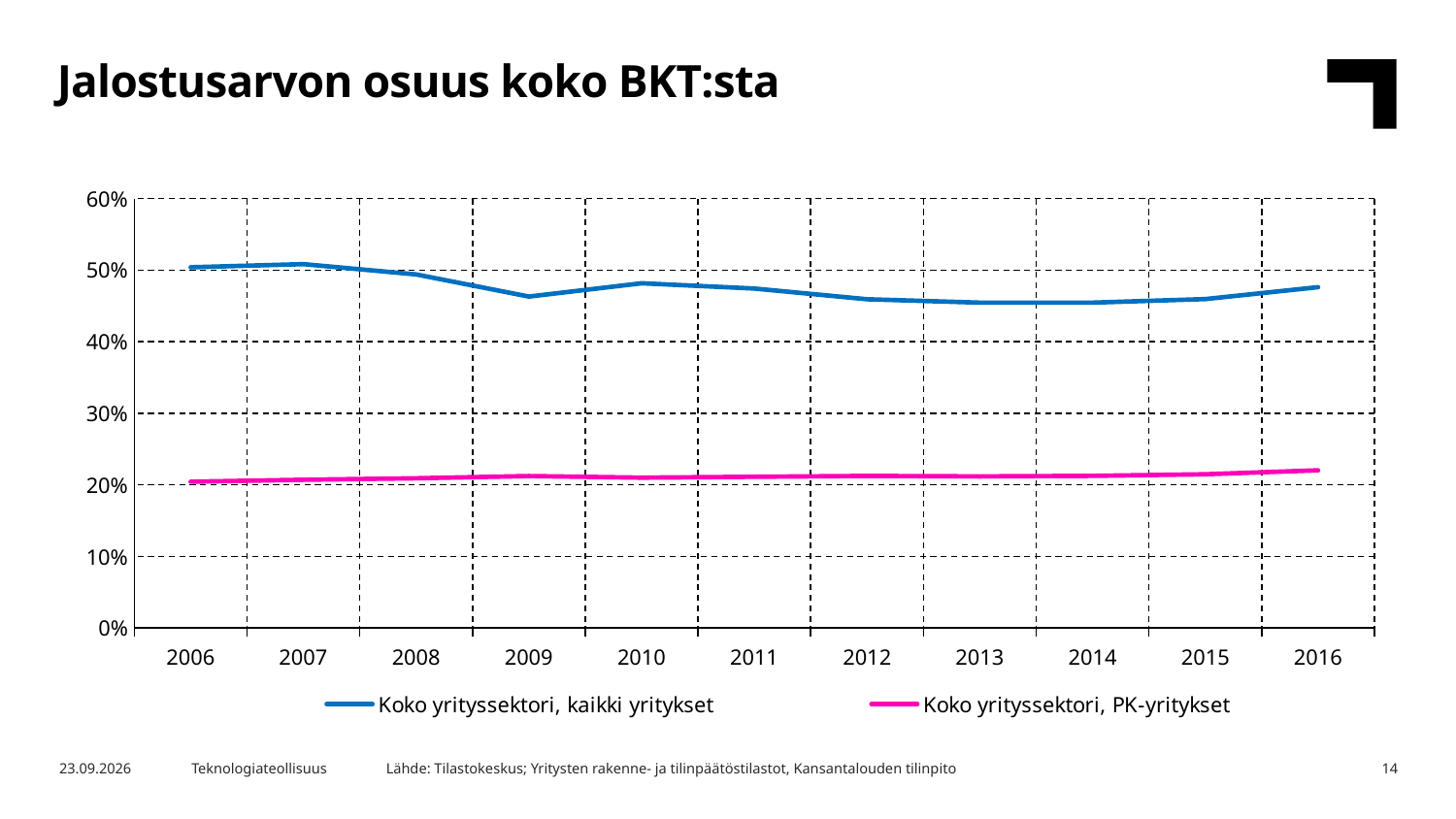
What kind of chart is shown on the slide? Line chart In 2010, which series has the higher value: Koko yrityssektori, kaikki yritykset or Koko yrityssektori, PK-yritykset? Koko yrityssektori, kaikki yritykset Which series is drawn in pink? Koko yrityssektori, PK-yritykset Is the value for Koko yrityssektori, PK-yritykset in 2016 greater or less than 20%? greater How many years are shown on the x axis? 11 In which year is the value for Koko yrityssektori, PK-yritykset highest? 2016 What is the title of the chart? Jalostusarvon osuus koko BKT:sta Does the value for Koko yrityssektori, PK-yritykset rise or fall overall from 2006 to 2016? rise Is the value for Koko yrityssektori, PK-yritykset in 2006 greater or less than 30%? less Is the value for Koko yrityssektori, kaikki yritykset in 2009 greater or less than 50%? less How many series does the legend list? 2